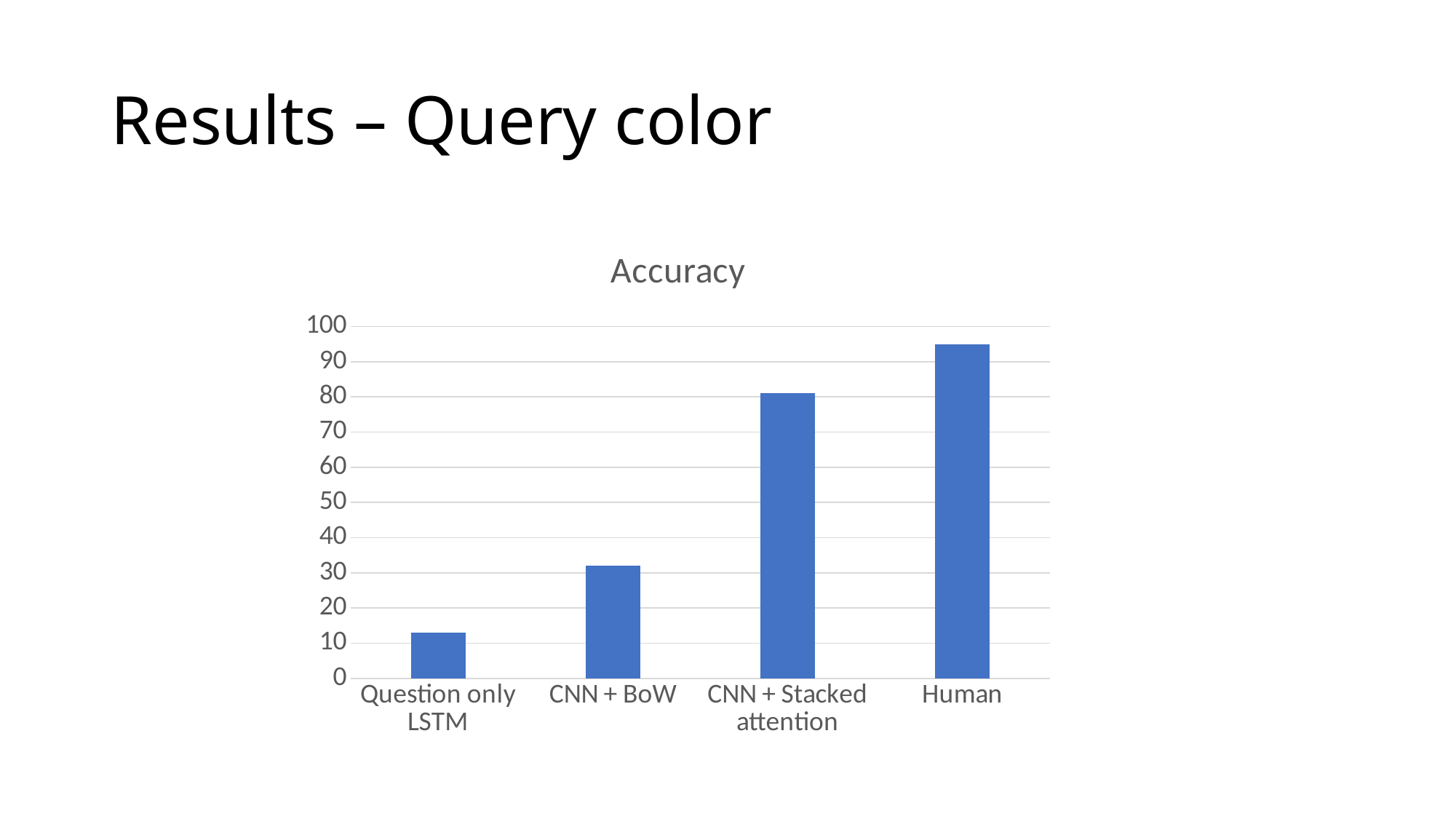
How many categories are shown on the x axis of the chart? 4 Which category has the highest accuracy? Human Which has a higher accuracy, CNN + BoW or CNN + Stacked attention? CNN + Stacked attention What is the title of the chart? Accuracy Is the value for Question only LSTM greater or less than 20? less What is the maximum value shown on the vertical axis? 100 Is the value for Human greater or less than 90? greater Do the values rise or fall from left to right along the x axis? rise What type of chart is shown on the slide? bar chart Which category has the lowest accuracy? Question only LSTM